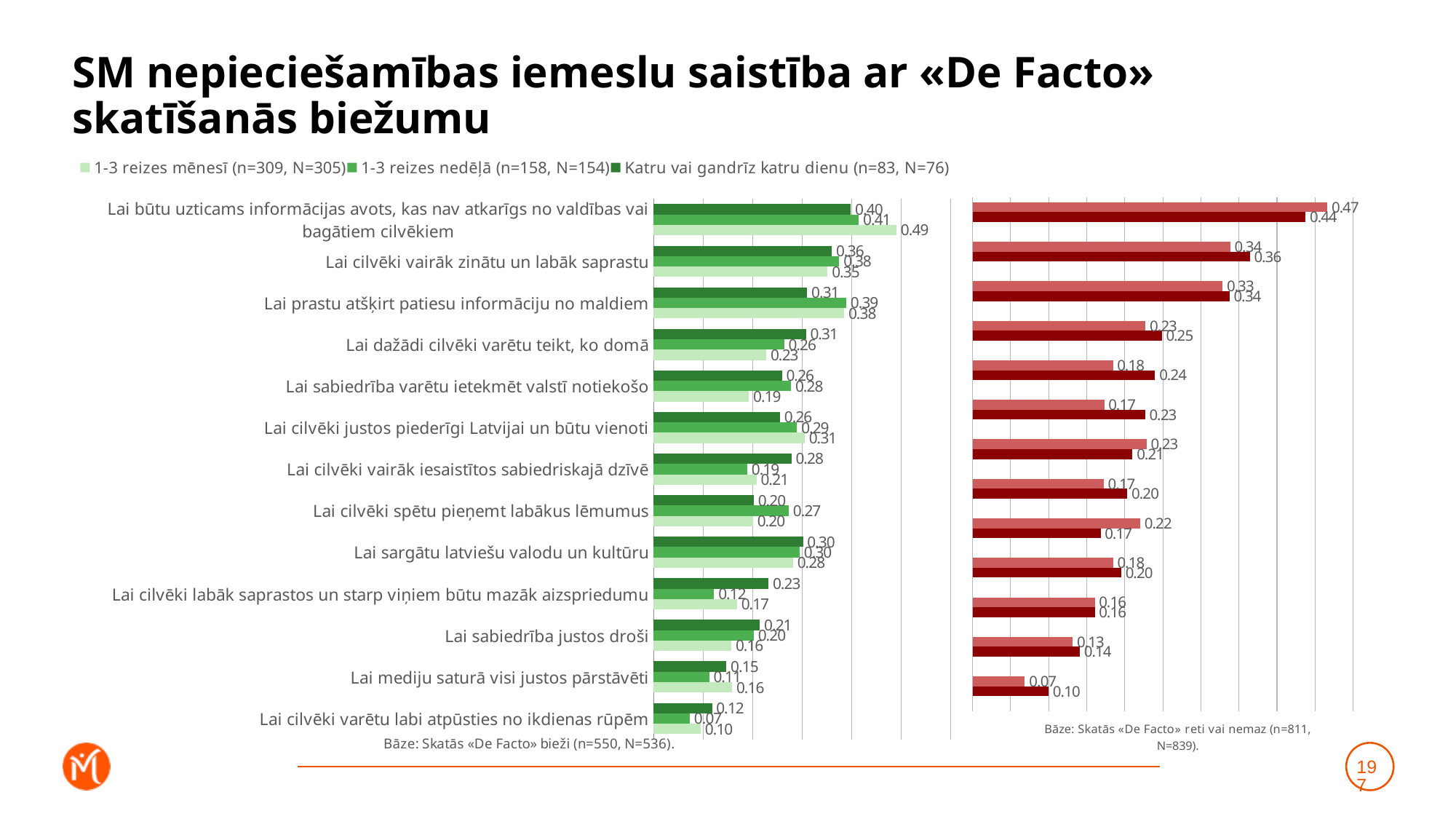
In the left (green) chart, which category has the highest value for '1-3 reizes mēnesī'? Lai būtu uzticams informācijas avots, kas nav atkarīgs no valdības vai bagātiem cilvēkiem In the left (green) chart, what is the value for '1-3 reizes nedēļā' for 'Lai prastu atšķirt patiesu informāciju no maldiem'? 0.39 How many series does the legend list for the left (green) chart? 3 What base note is printed under the left (green) chart? Bāze: Skatās «De Facto» bieži (n=550, N=536). What kind of chart is shown on the left side of the slide? bar chart In the left (green) chart, for 'Lai cilvēki spētu pieņemt labākus lēmumus', what is the difference between the '1-3 reizes nedēļā' value and the '1-3 reizes mēnesī' value? 0.07 In the left (green) chart, for 'Lai sabiedrība varētu ietekmēt valstī notiekošo', which series has the larger value: 'Katru vai gandrīz katru dienu' or '1-3 reizes mēnesī'? Katru vai gandrīz katru dienu In the left (green) chart, what is the value for 'Katru vai gandrīz katru dienu' for 'Lai dažādi cilvēki varētu teikt, ko domā'? 0.31 In the right (red) chart, what is the highest value shown? 0.47 In the right (red) chart, what is the lowest value shown? 0.07 In the left (green) chart, what is the value for '1-3 reizes mēnesī' for 'Lai būtu uzticams informācijas avots, kas nav atkarīgs no valdības vai bagātiem cilvēkiem'? 0.49 How many categories are listed on the left (green) chart? 13